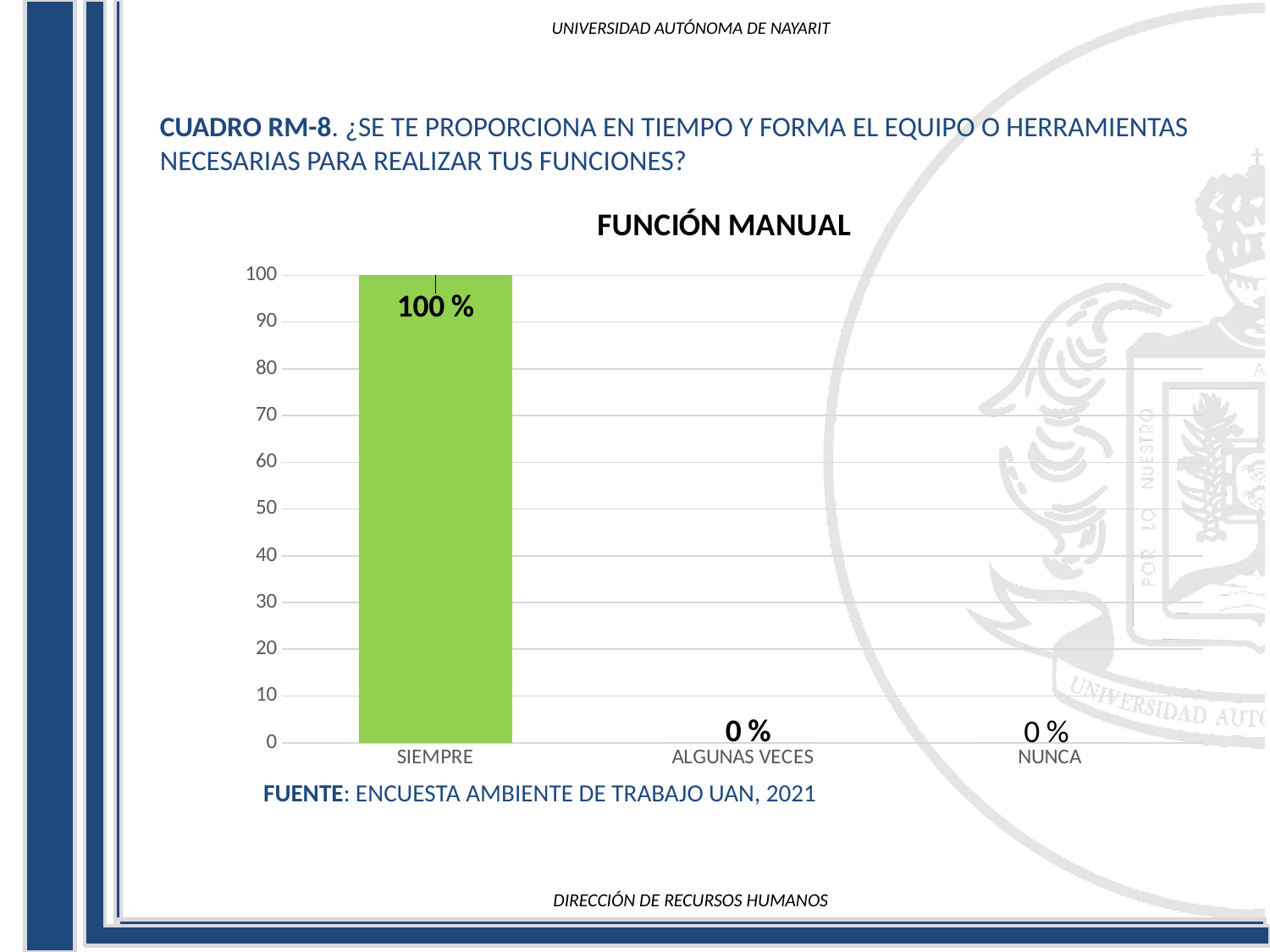
What is the value for NUNCA? 0 % Which is larger, the value for SIEMPRE or the value for NUNCA? SIEMPRE What is the difference between the values for SIEMPRE and ALGUNAS VECES? 100 % What is the value for ALGUNAS VECES? 0 % What kind of chart is shown on the slide? bar chart What is the value for SIEMPRE? 100 % Which category has the highest value? SIEMPRE What is the title of the chart? FUNCIÓN MANUAL What colour is the bar for SIEMPRE? green How many categories are shown on the x axis? 3 Is the value for SIEMPRE greater or less than 50? greater Do the values rise or fall from SIEMPRE to NUNCA along the x axis? fall